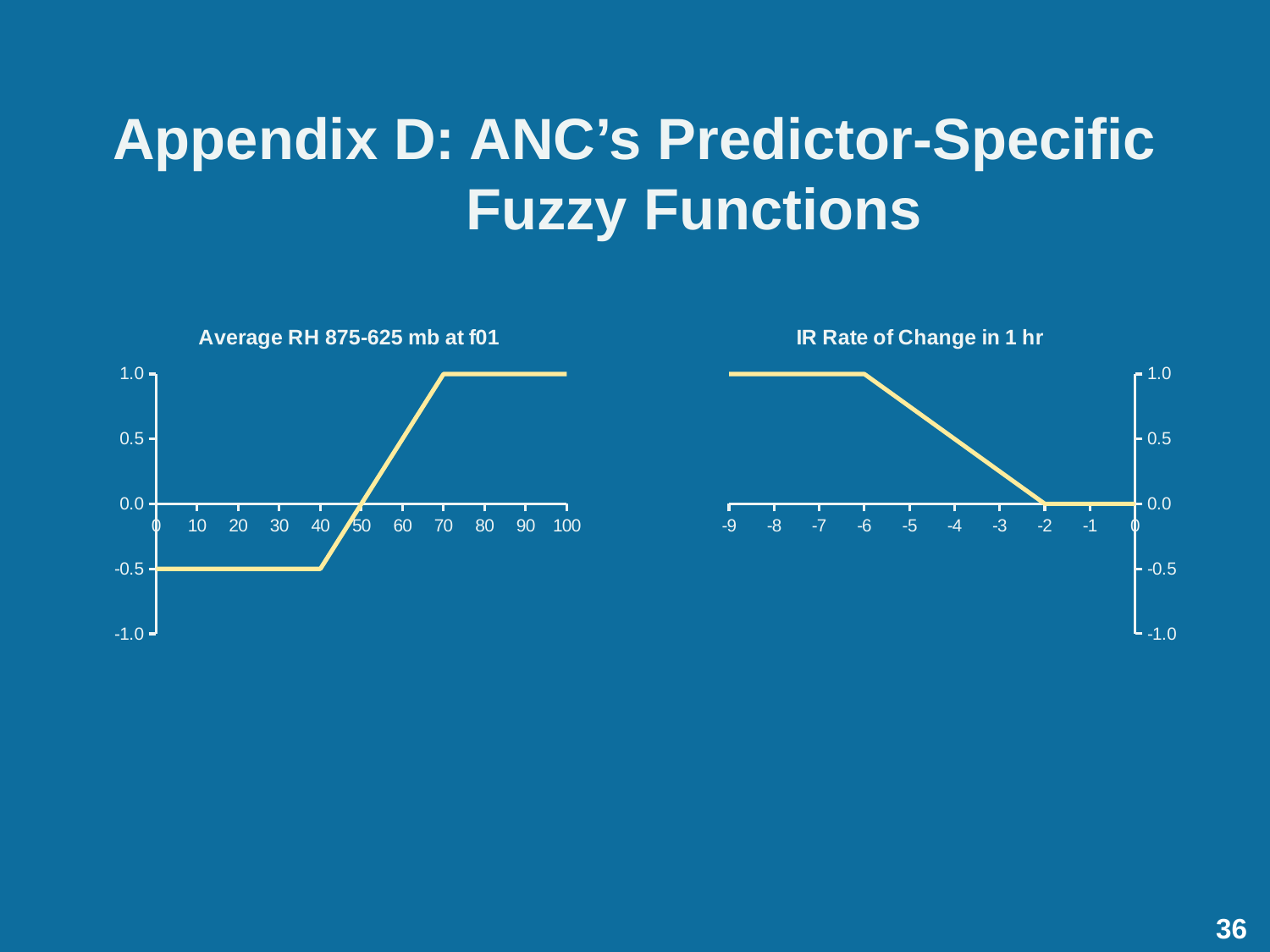
In the "IR Rate of Change in 1 hr" chart, does the line rise or fall between x = -6 and x = -2? fall In the "Average RH 875-625 mb at f01" chart, what is the value of the line at x = 70? 1.0 In the "Average RH 875-625 mb at f01" chart, is the value at x = 60 greater or less than 0.0? greater What is the title of the chart on the right side of the slide? IR Rate of Change in 1 hr In the "IR Rate of Change in 1 hr" chart, what is the value of the line at x = -8? 1.0 In the "IR Rate of Change in 1 hr" chart, what is the value of the line at x = -4? 0.5 In the "Average RH 875-625 mb at f01" chart, what is the value of the line at x = 20? -0.5 In the "IR Rate of Change in 1 hr" chart, is the value at x = -3 greater or less than 0.5? less What kind of chart is the "Average RH 875-625 mb at f01" chart? line chart In the "Average RH 875-625 mb at f01" chart, does the line rise or fall between x = 40 and x = 70? rise In the "IR Rate of Change in 1 hr" chart, what is the value of the line at x = -1? 0.0 In the "Average RH 875-625 mb at f01" chart, what is the value of the line at x = 50? 0.0